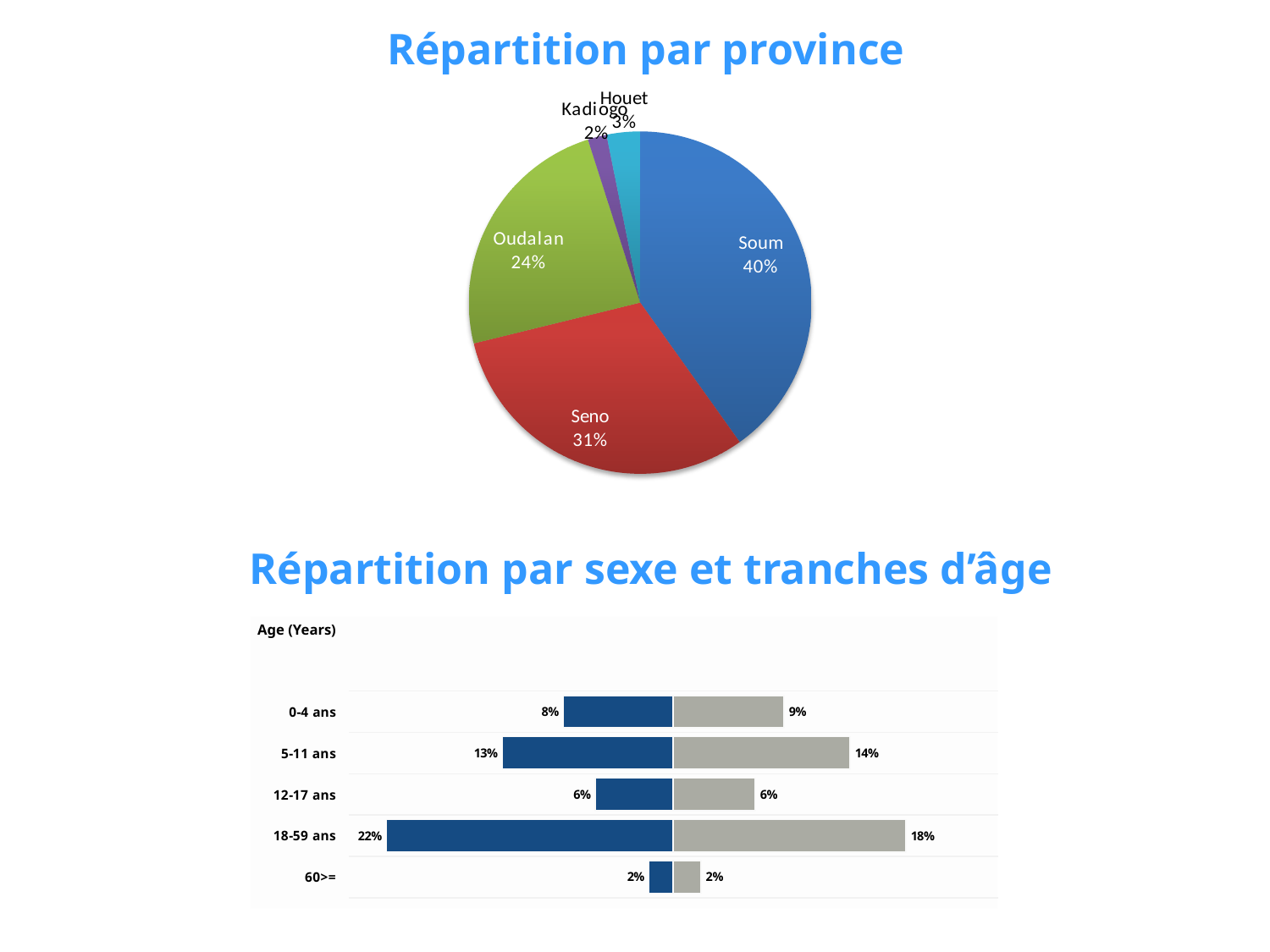
In the 'Répartition par sexe et tranches d'âge' chart, what is the value of the left (blue) bar for 18-59 ans? 22% In the 'Répartition par province' pie chart, how many provinces are shown? 5 In the 'Répartition par province' pie chart, what share does Soum have? 40% What kind of chart is 'Répartition par province'? Pie chart In the 'Répartition par sexe et tranches d'âge' chart, what is the value of the right (grey) bar for 5-11 ans? 14% In the 'Répartition par province' pie chart, what is the difference between the shares of Seno and Oudalan? 7% In the 'Répartition par sexe et tranches d'âge' chart, which age group has the largest left (blue) bar? 18-59 ans In the 'Répartition par province' pie chart, which province has the largest slice? Soum In the 'Répartition par province' pie chart, what share does Oudalan have? 24% In the 'Répartition par province' pie chart, which province has the smallest slice? Kadiogo In the 'Répartition par sexe et tranches d'âge' chart, how many age groups are shown? 5 What kind of chart is 'Répartition par sexe et tranches d'âge'? Bar chart